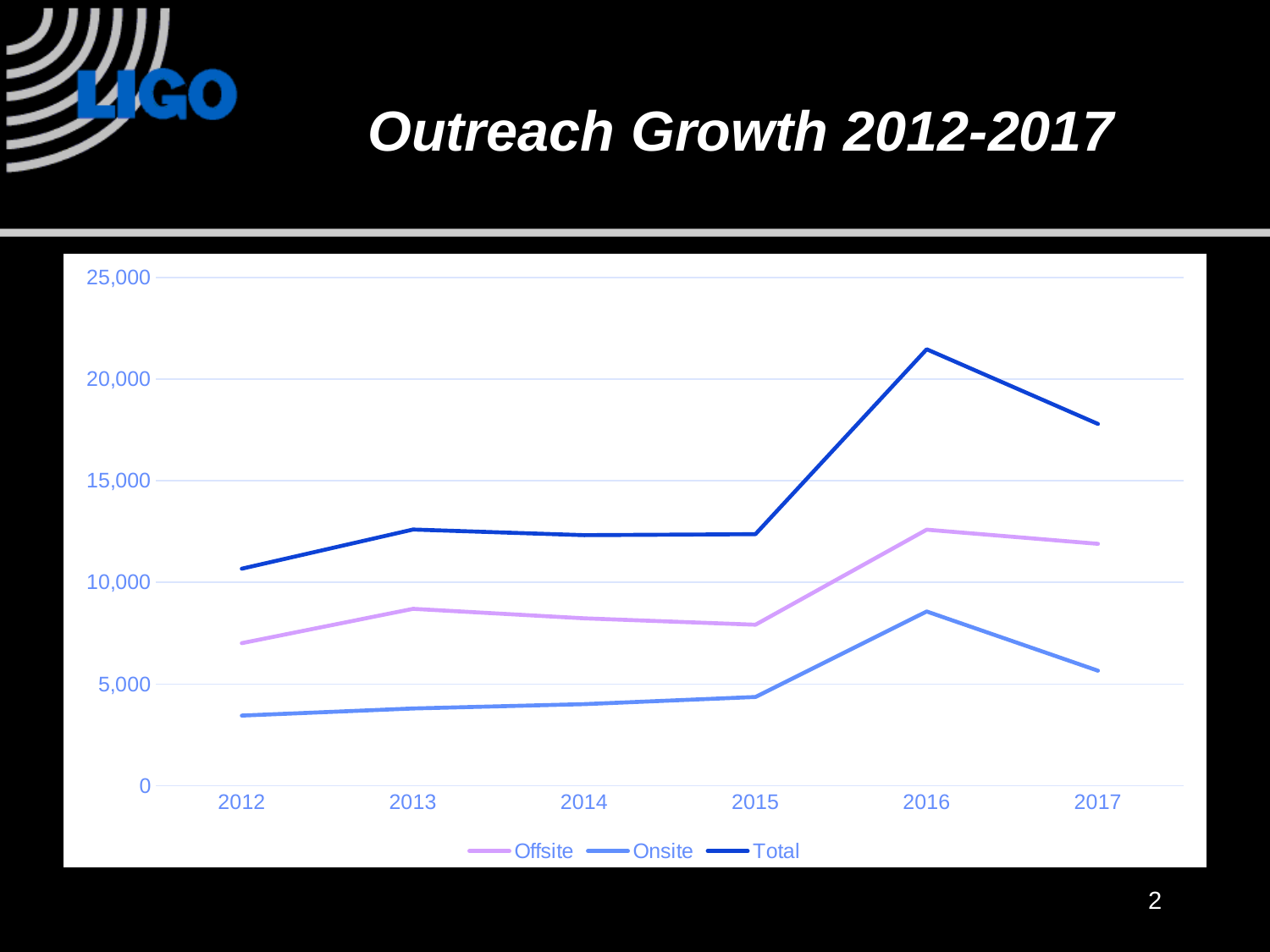
Which is larger in 2017, the Offsite value or the Onsite value? Offsite Is the Onsite value for 2012 greater or less than 5,000? less What kind of chart is shown on the slide? line chart Is the Total value for 2016 greater or less than 20,000? greater How many series does the legend list? 3 In which year does the Total series reach its highest value? 2016 Does the Total series rise or fall from 2016 to 2017? fall Is the Total value for 2017 greater or less than 15,000? greater How many years are plotted along the x axis? 6 What is the title of the chart on the slide? Outreach Growth 2012-2017 In which year is the Onsite series at its lowest? 2012